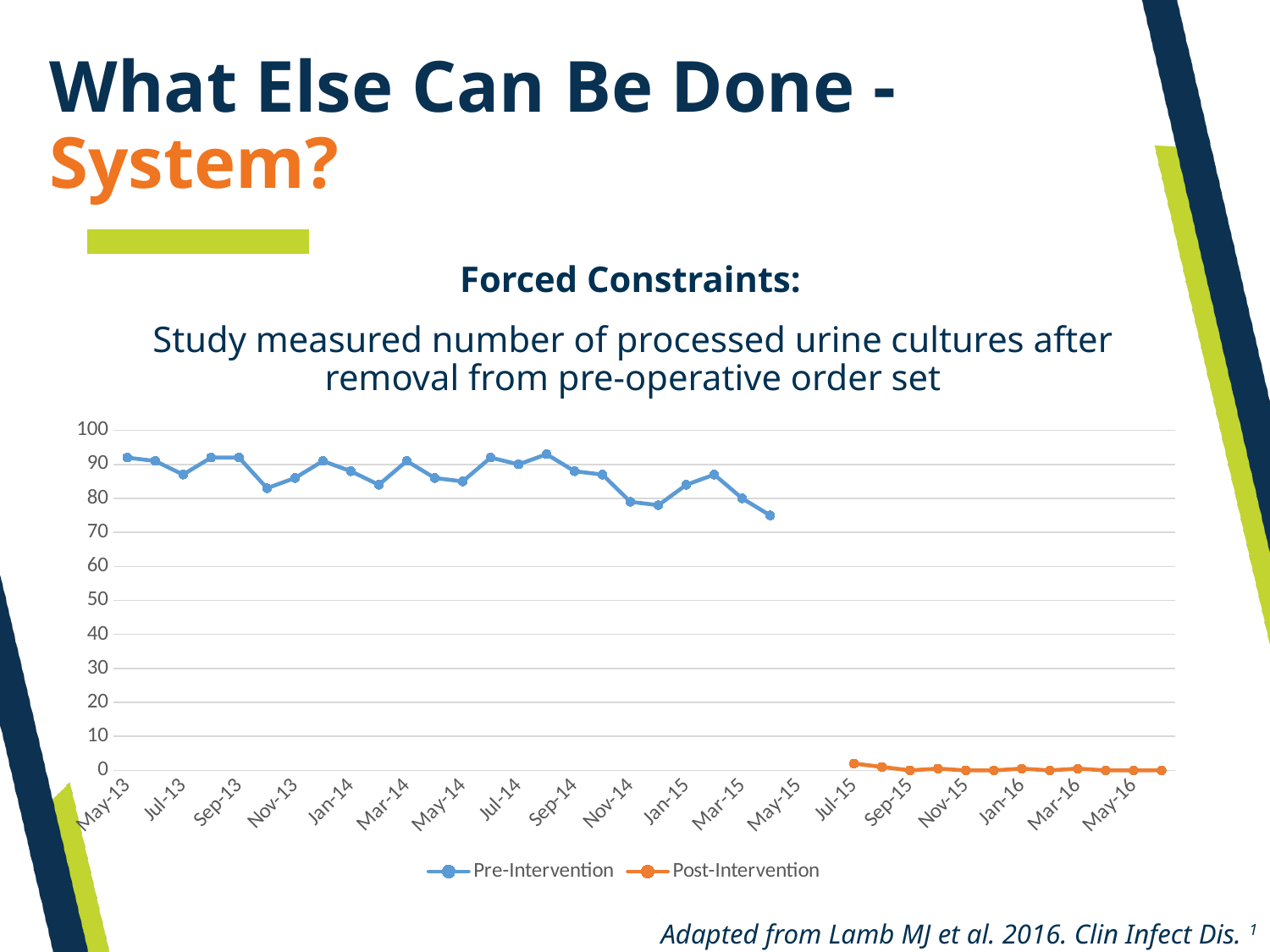
Which series has higher values, Pre-Intervention or Post-Intervention? Pre-Intervention Do the Pre-Intervention values overall rise or fall from May-13 to their last point? fall Which series is drawn in blue? Pre-Intervention Which series is drawn in orange? Post-Intervention Is the Post-Intervention value at Jan-16 greater or less than 10? less What kind of chart is shown on the slide? line chart Is the Post-Intervention value at Jul-15 greater or less than 10? less Is the Pre-Intervention value at May-13 greater or less than 80? greater What is the highest value shown on the y axis? 100 How many series does the legend list? 2